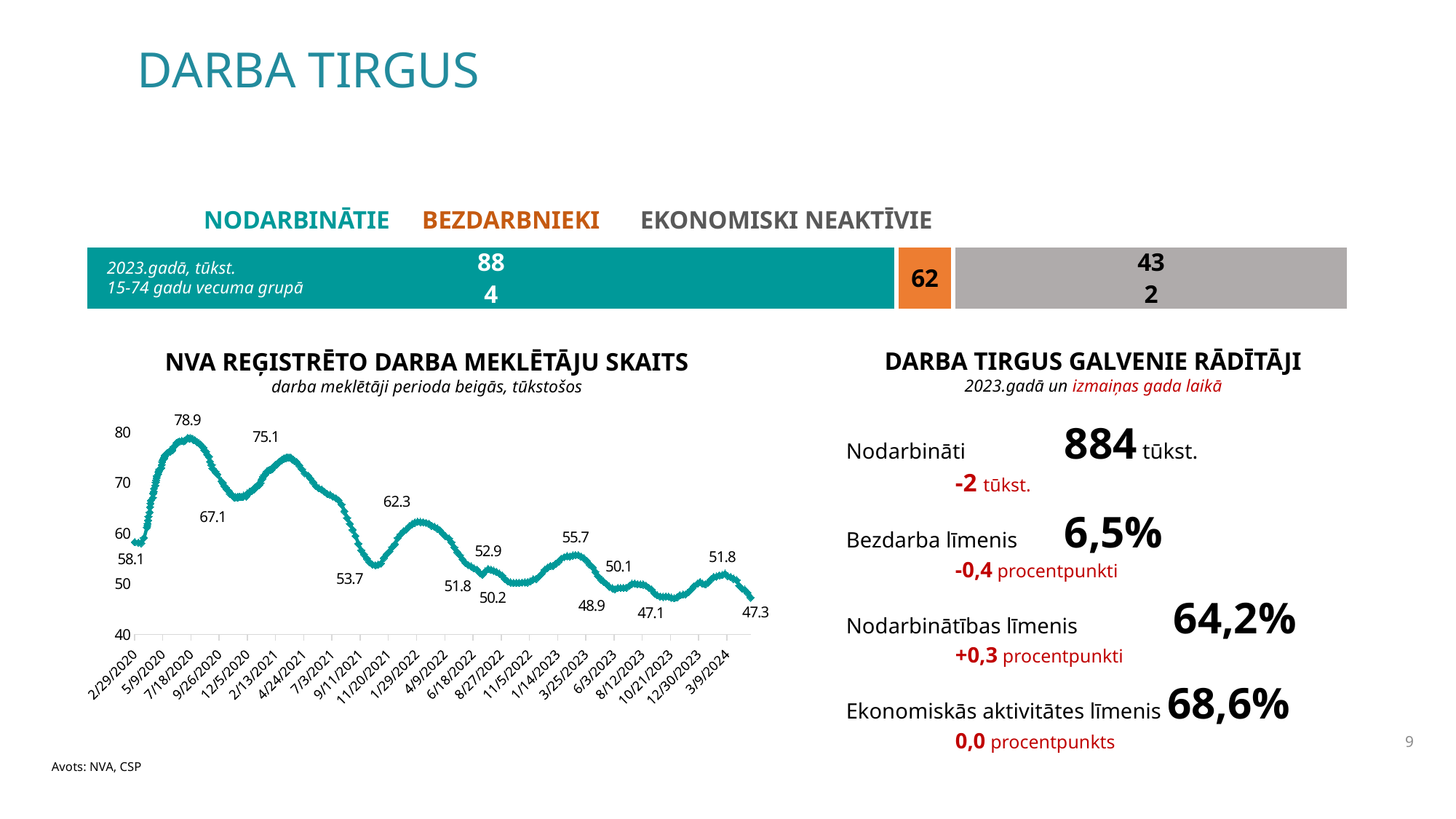
In the chart 'NVA REĢISTRĒTO DARBA MEKLĒTĀJU SKAITS', what is the highest labelled value? 78.9 In the chart 'NVA REĢISTRĒTO DARBA MEKLĒTĀJU SKAITS', what is the lowest labelled value? 47.1 In the stacked bar chart at the top of the slide, which segment is the largest? NODARBINĀTIE In the chart 'NVA REĢISTRĒTO DARBA MEKLĒTĀJU SKAITS', what is the difference between the highest labelled value (78.9) and the final labelled value (47.3)? 31.6 In the stacked bar chart at the top of the slide, what is the total of the three segments (884, 62 and 432)? 1378 In the chart 'NVA REĢISTRĒTO DARBA MEKLĒTĀJU SKAITS', which is larger: the first labelled value (58.1) or the last labelled value (47.3)? 58.1 In the chart 'NVA REĢISTRĒTO DARBA MEKLĒTĀJU SKAITS', what is the last labelled value at the right end of the line? 47.3 What kind of chart is 'NVA REĢISTRĒTO DARBA MEKLĒTĀJU SKAITS'? line chart In the chart 'NVA REĢISTRĒTO DARBA MEKLĒTĀJU SKAITS', is the value around 12/5/2020 greater or less than 60? greater In the chart 'NVA REĢISTRĒTO DARBA MEKLĒTĀJU SKAITS', do the values overall rise or fall from 2020 to 2024? fall How many segments does the stacked bar chart at the top of the slide have? 3 In the stacked bar chart at the top of the slide, what is the value for BEZDARBNIEKI? 62